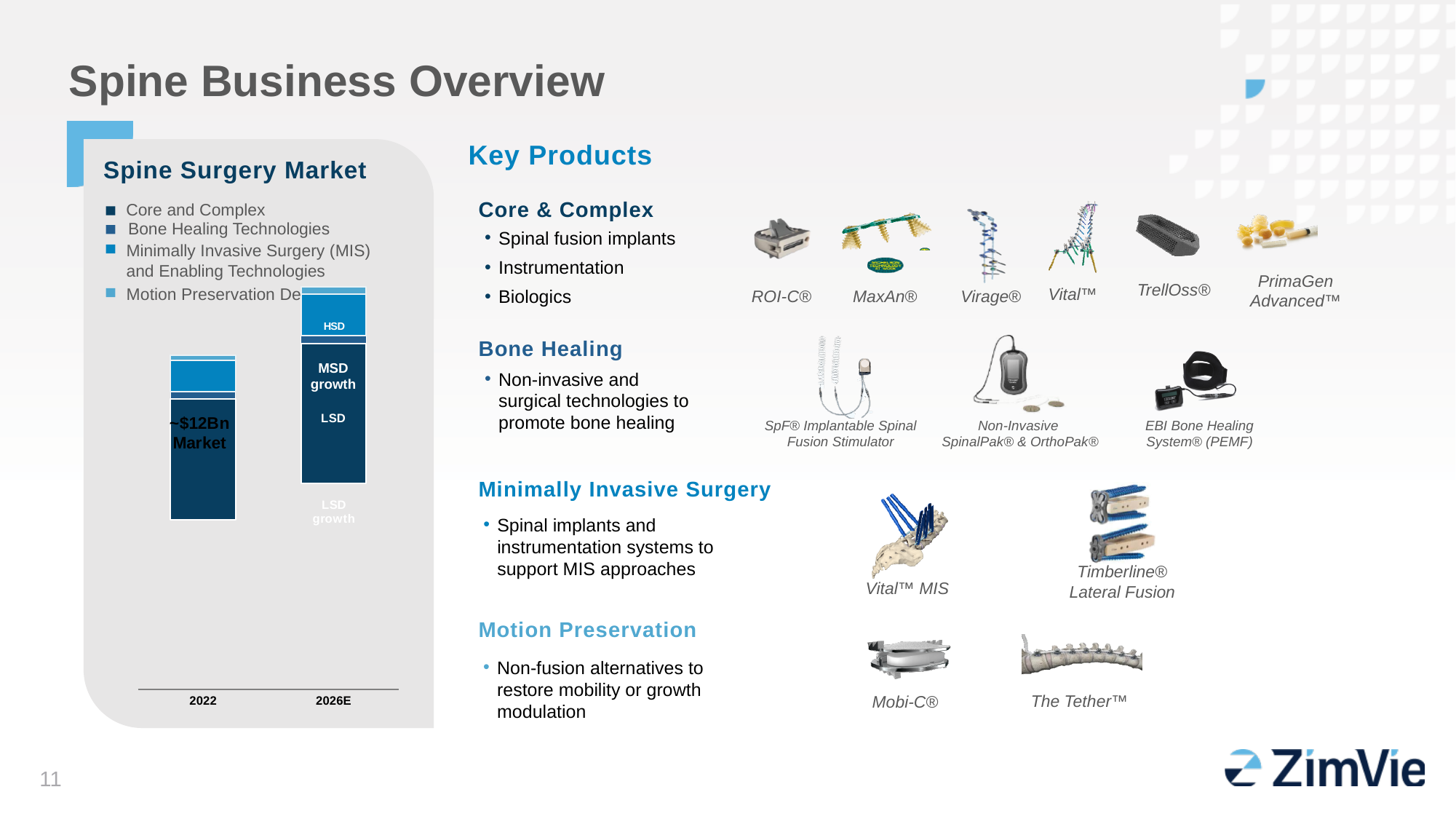
What kind of chart is shown in the Spine Surgery Market panel? Stacked bar chart What label is printed on the top segment of the 2026E bar in the Spine Surgery Market chart? HSD What label is printed on the bottom dark segment of the 2026E bar in the Spine Surgery Market chart? LSD What are the two category labels on the x axis of the Spine Surgery Market chart? 2022 and 2026E What label appears below the 2026E bar in the Spine Surgery Market chart? LSD growth Which bar in the Spine Surgery Market chart is the shortest? 2022 What text is printed on the 2022 bar in the Spine Surgery Market chart? ~$12Bn Market How many bars (categories) does the Spine Surgery Market chart show? 2 Which bar is taller in the Spine Surgery Market chart, 2022 or 2026E? 2026E What label is printed on the middle segment of the 2026E bar in the Spine Surgery Market chart? MSD growth Do the bars in the Spine Surgery Market chart rise or fall from 2022 to 2026E? Rise